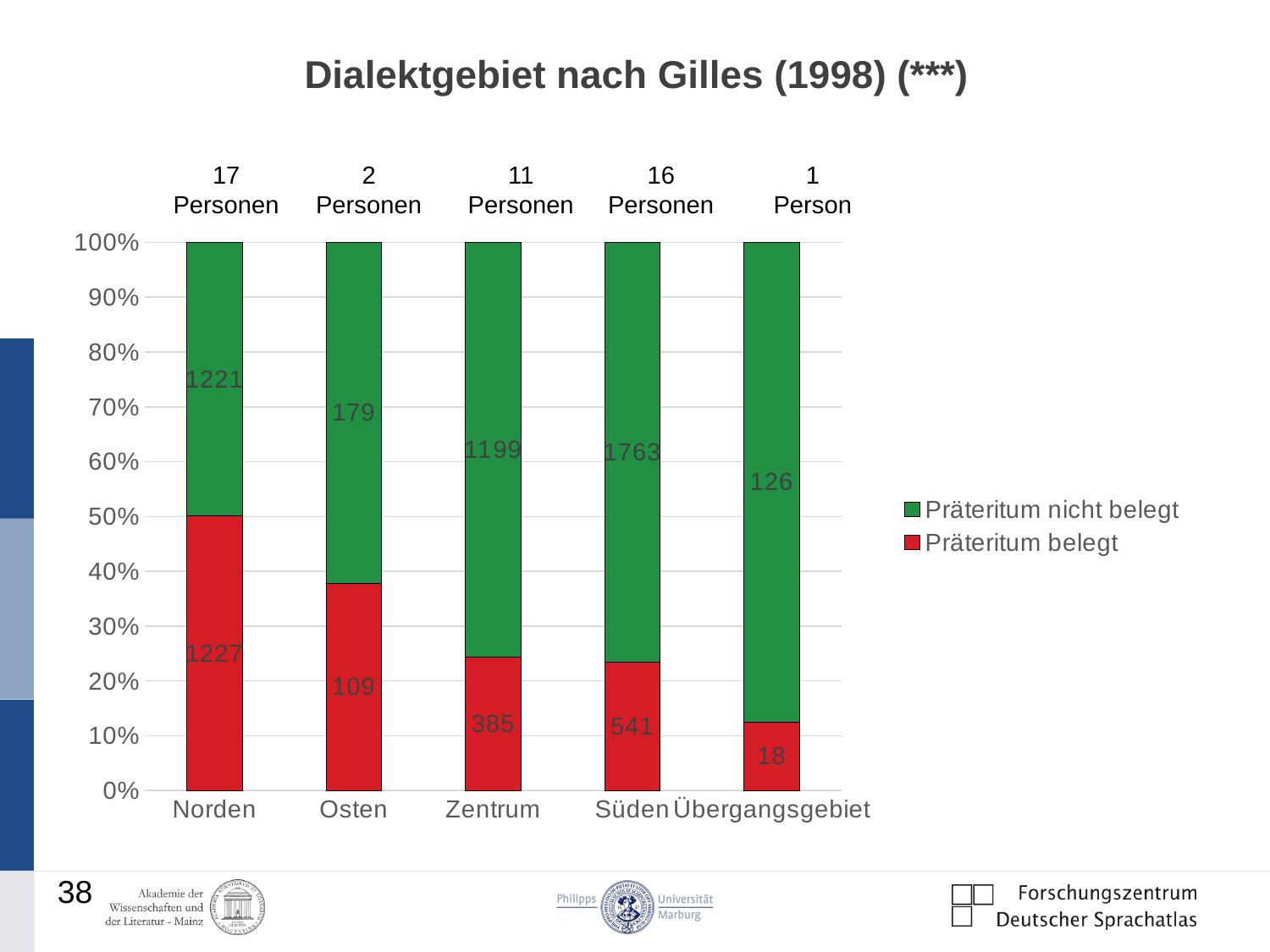
What is the value for 'Präteritum belegt' in Übergangsgebiet? 18 How many dialect regions (categories) are shown on the x axis? 5 How many persons are listed above the Süden bar? 16 Personen What is the difference between 'Präteritum nicht belegt' and 'Präteritum belegt' in Zentrum? 814 What is the value for 'Präteritum nicht belegt' in Süden? 1763 What is the value for 'Präteritum belegt' in Norden? 1227 Which region has the highest value for 'Präteritum nicht belegt'? Süden What type of chart is shown on the slide? stacked bar chart Is the 'Präteritum belegt' share of the Osten bar greater or less than 30%? greater What is the total of the two values in the Osten bar? 288 How many series does the legend list? 2 Which region has the lowest value for 'Präteritum belegt'? Übergangsgebiet